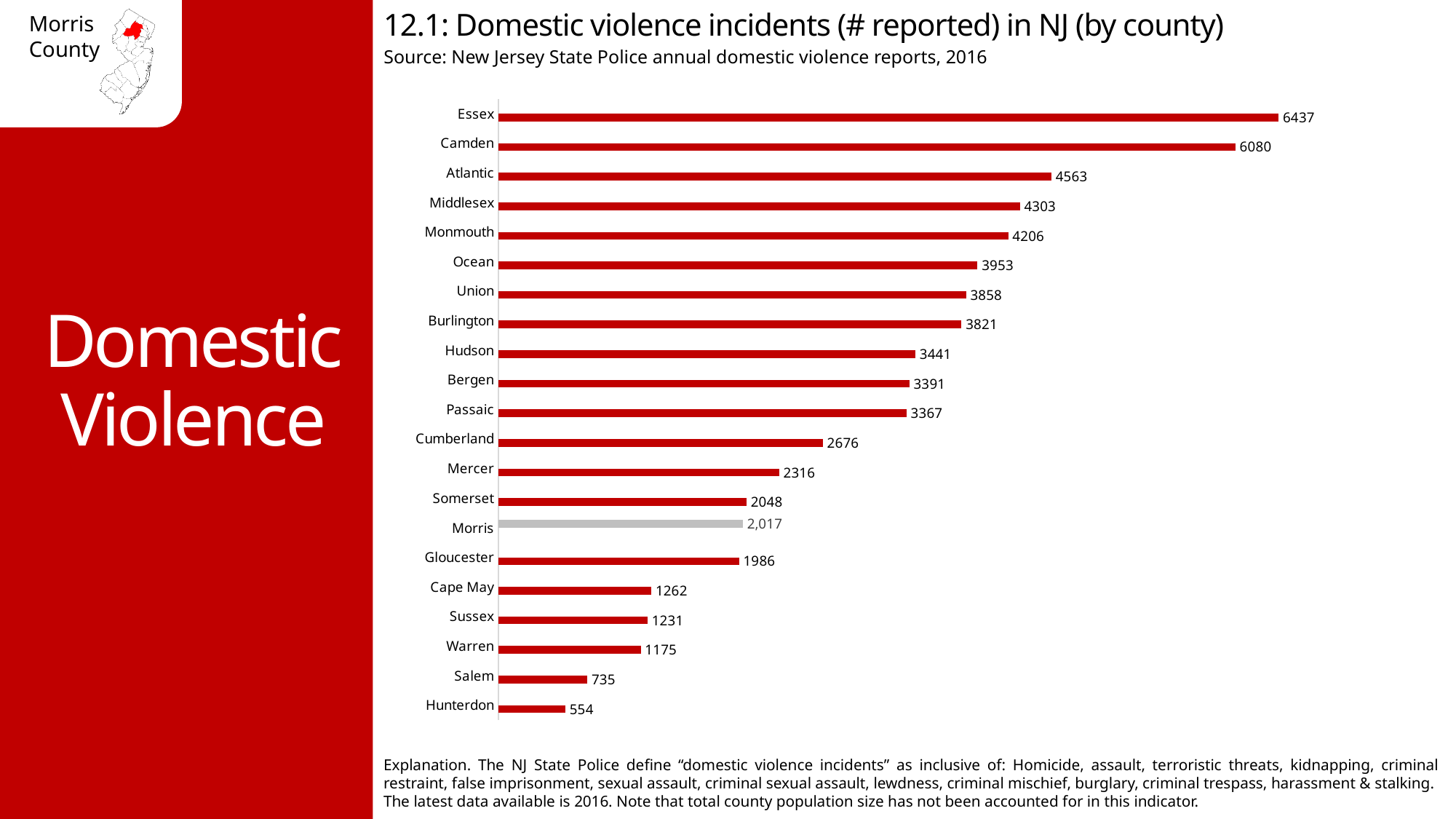
What is the difference between the number of incidents in Essex and Camden? 357 What kind of chart is shown on the slide? Bar chart How many counties are shown in the chart? 21 How many domestic violence incidents were reported in Salem County? 735 How many domestic violence incidents were reported in Morris County? 2,017 Which county reported more domestic violence incidents, Cape May or Sussex? Cape May Which county reported more domestic violence incidents, Hudson or Bergen? Hudson Which county has the lowest number of reported domestic violence incidents? Hunterdon What is the difference between the number of incidents in Somerset and Morris? 31 Which county has the highest number of reported domestic violence incidents? Essex Which county's bar is shown in grey instead of red? Morris Do the values increase or decrease going from the top bar to the bottom bar? Decrease